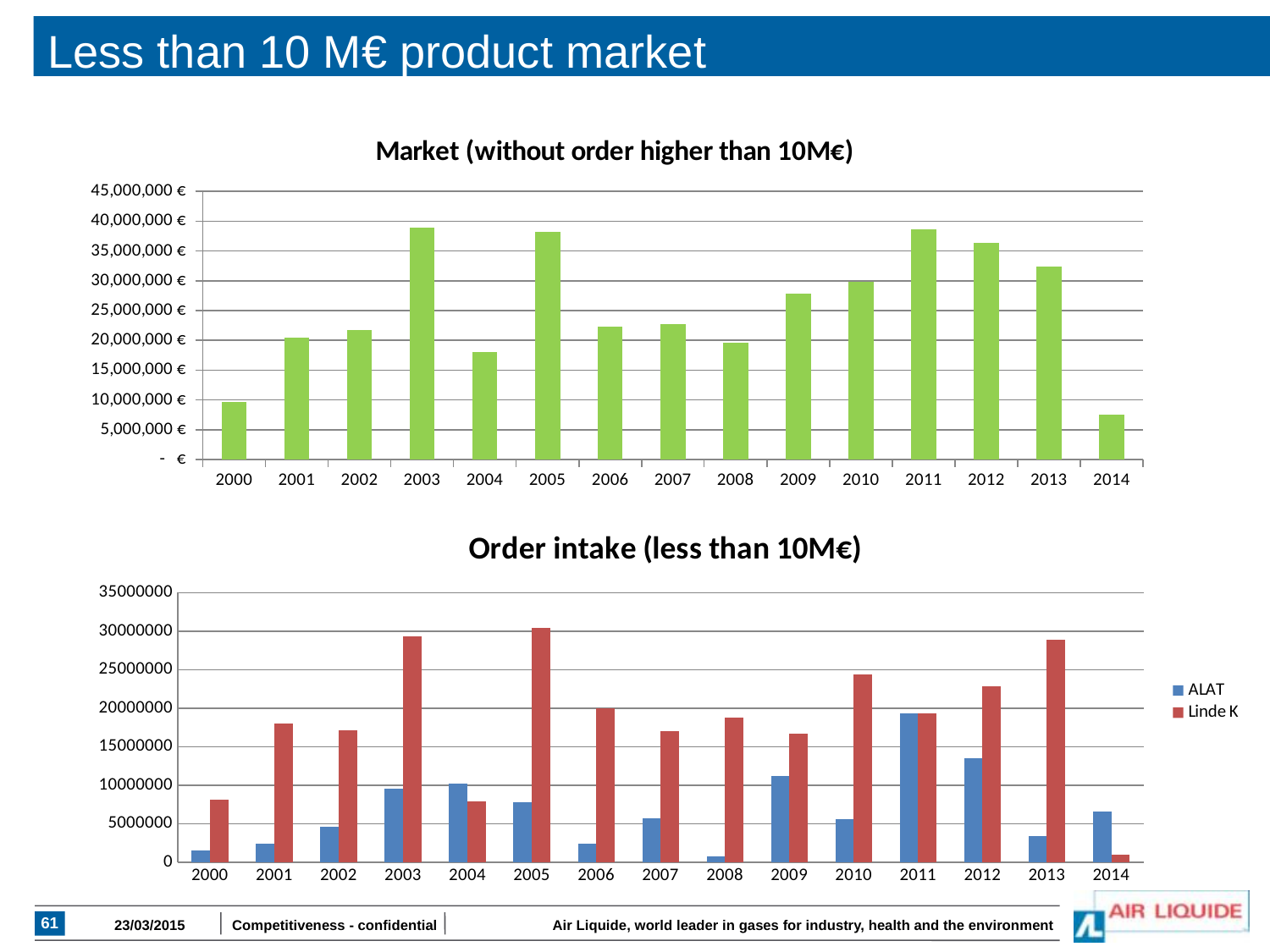
In the 'Market (without order higher than 10M€)' chart, which year has the lowest value? 2014 In the 'Order intake (less than 10M€)' chart, which year has the highest ALAT value? 2011 In the 'Order intake (less than 10M€)' chart, which series has the larger value in 2004, ALAT or Linde K? ALAT What type of chart is the 'Market (without order higher than 10M€)' chart? bar chart In the 'Order intake (less than 10M€)' chart, which year has the lowest Linde K value? 2014 How many series does the legend of the 'Order intake (less than 10M€)' chart list? 2 In the 'Market (without order higher than 10M€)' chart, how many years are shown on the x axis? 15 In the 'Market (without order higher than 10M€)' chart, is the value for 2003 greater or less than 35,000,000 €? greater In the 'Market (without order higher than 10M€)' chart, is the value for 2009 greater or less than 25,000,000 €? greater In the 'Order intake (less than 10M€)' chart, is the Linde K value for 2010 greater or less than 20000000? greater In the 'Market (without order higher than 10M€)' chart, which year has the larger value, 2004 or 2005? 2005